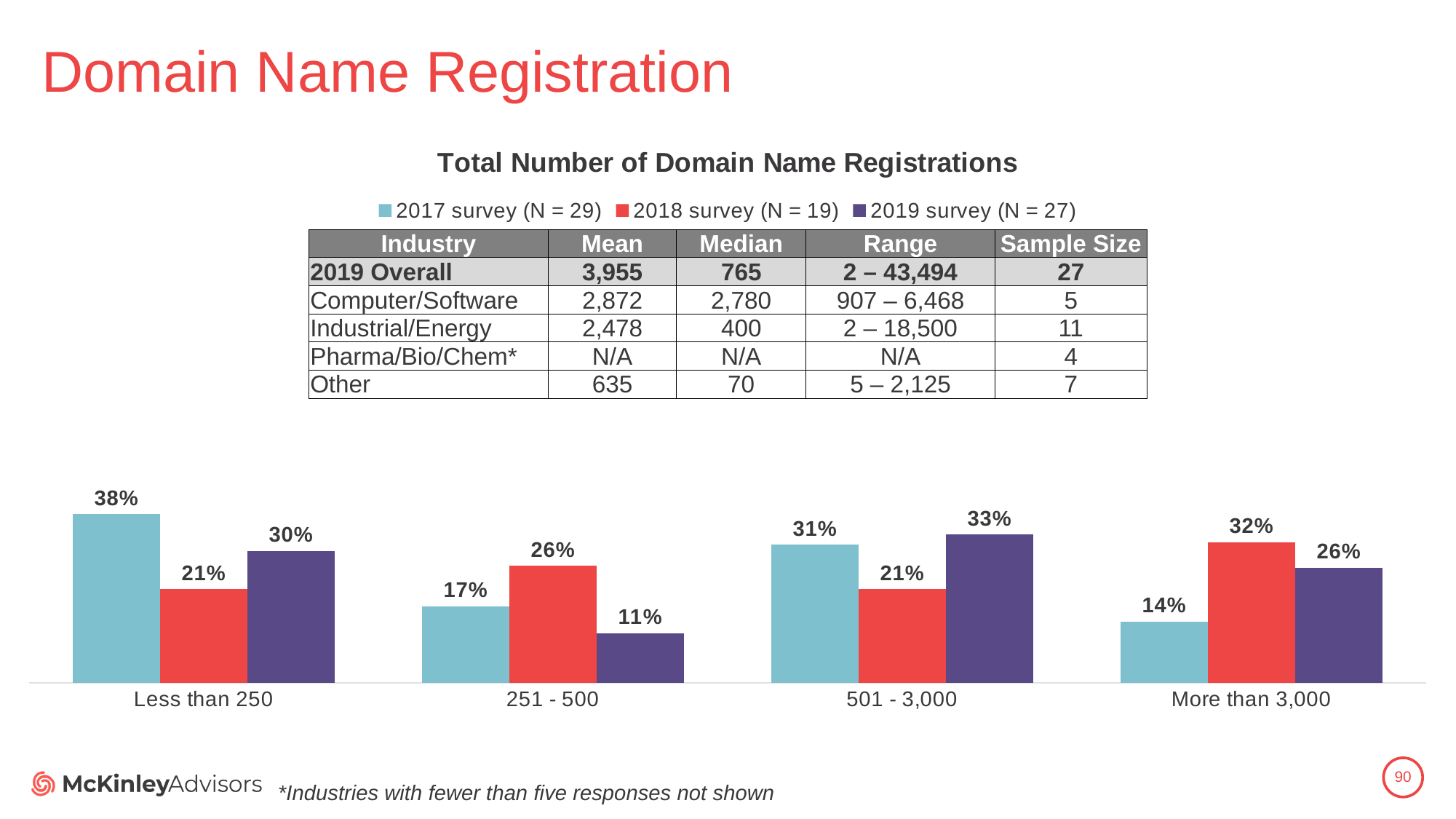
What is the value for the 2018 survey in the 'More than 3,000' category? 32% What kind of chart is shown on the slide? Bar chart What is the value for the 2017 survey in the 'Less than 250' category? 38% What is the title of the chart? Total Number of Domain Name Registrations Which category has the highest value for the 2019 survey? 501 - 3,000 How many series does the chart legend list? 3 Which category has the lowest value for the 2017 survey? More than 3,000 What is the value for the 2019 survey in the '251 - 500' category? 11% How many categories are shown on the x axis of the chart? 4 What is the difference between the 2017 survey and 2018 survey values in the 'Less than 250' category? 17% In the '501 - 3,000' category, which is larger: the 2017 survey value or the 2019 survey value? 2019 survey